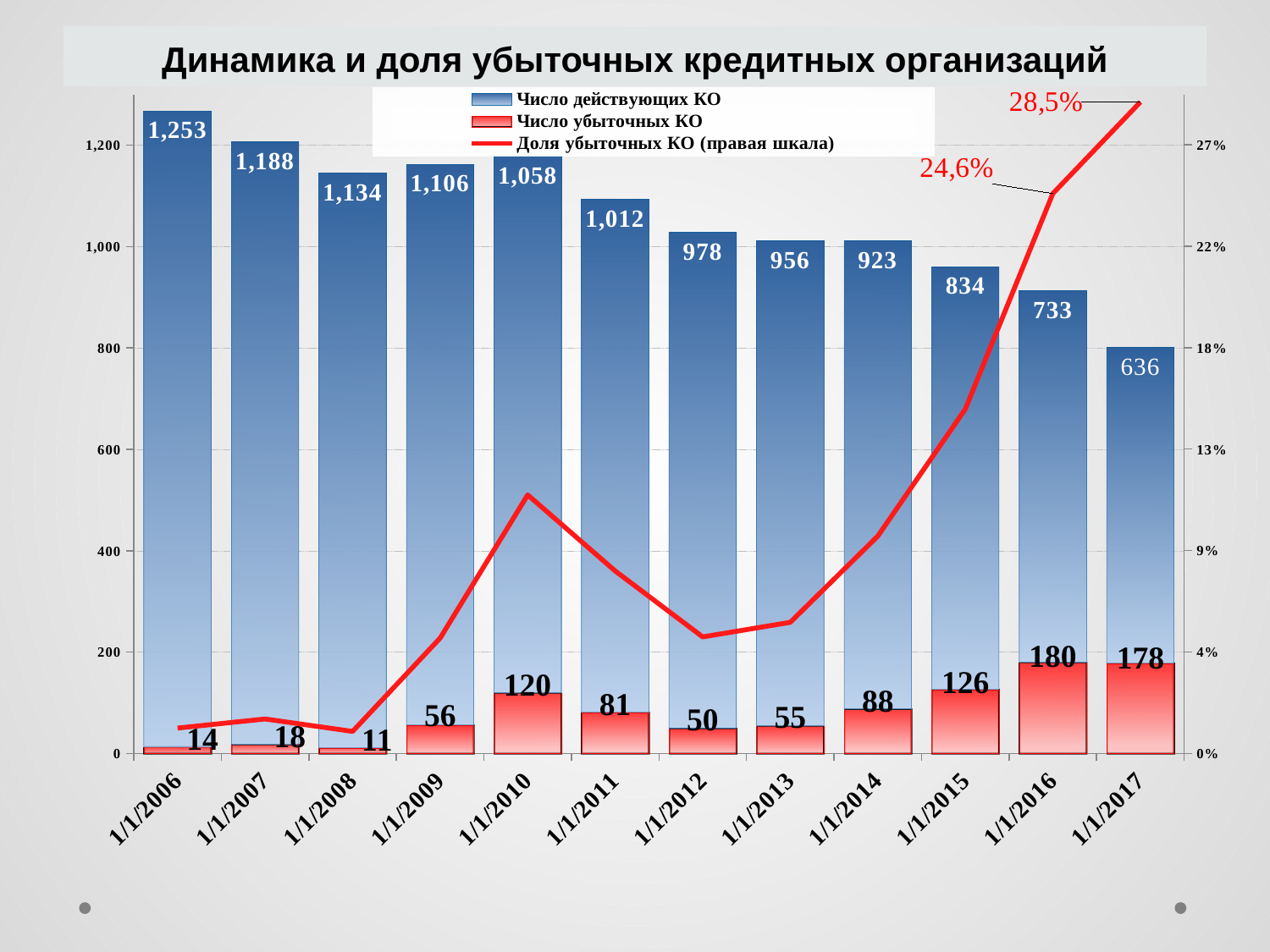
What is the value of "Доля убыточных КО" for 1/1/2017? 28,5% How many series does the legend list? 3 Is the value of "Доля убыточных КО" for 1/1/2010 greater or less than 9%? greater Which date has the lowest value of "Число убыточных КО"? 1/1/2008 Which date has the highest value of "Число убыточных КО"? 1/1/2016 Does "Число действующих КО" rise or fall from 1/1/2006 to 1/1/2017? fall How many dates are shown on the x axis? 12 What is the value of "Число действующих КО" for 1/1/2006? 1,253 What is the value of "Число убыточных КО" for 1/1/2010? 120 Which is larger: "Число убыточных КО" for 1/1/2011 or for 1/1/2014? 1/1/2014 What is the difference between "Число действующих КО" for 1/1/2016 and 1/1/2017? 97 What is the value of "Число действующих КО" for 1/1/2017? 636